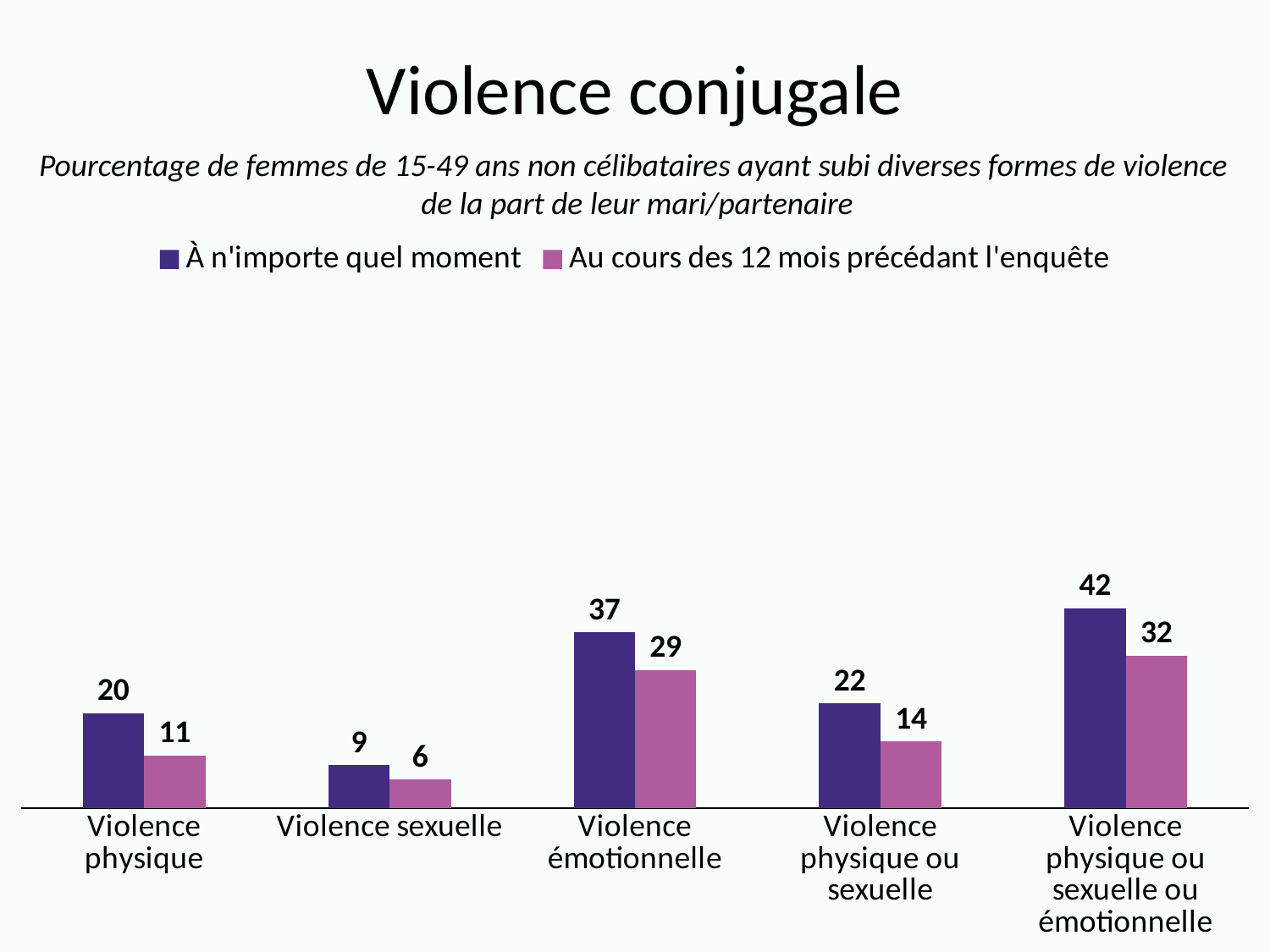
How many series does the legend list? 2 What is the value for 'À n'importe quel moment' in the 'Violence physique' category? 20 What is the value for 'Au cours des 12 mois précédant l'enquête' in the 'Violence émotionnelle' category? 29 What is the value for 'Au cours des 12 mois précédant l'enquête' in the 'Violence sexuelle' category? 6 Which is larger: the 'À n'importe quel moment' value for 'Violence émotionnelle' or for 'Violence physique ou sexuelle'? Violence émotionnelle What is the difference between the 'À n'importe quel moment' and 'Au cours des 12 mois précédant l'enquête' values for 'Violence physique ou sexuelle'? 8 Which category has the lowest value for 'Au cours des 12 mois précédant l'enquête'? Violence sexuelle How many categories are shown on the x axis? 5 What kind of chart is shown on the slide? Bar chart Which series is shown in dark purple? À n'importe quel moment What is the title of the chart? Violence conjugale Which category has the highest value for 'À n'importe quel moment'? Violence physique ou sexuelle ou émotionnelle